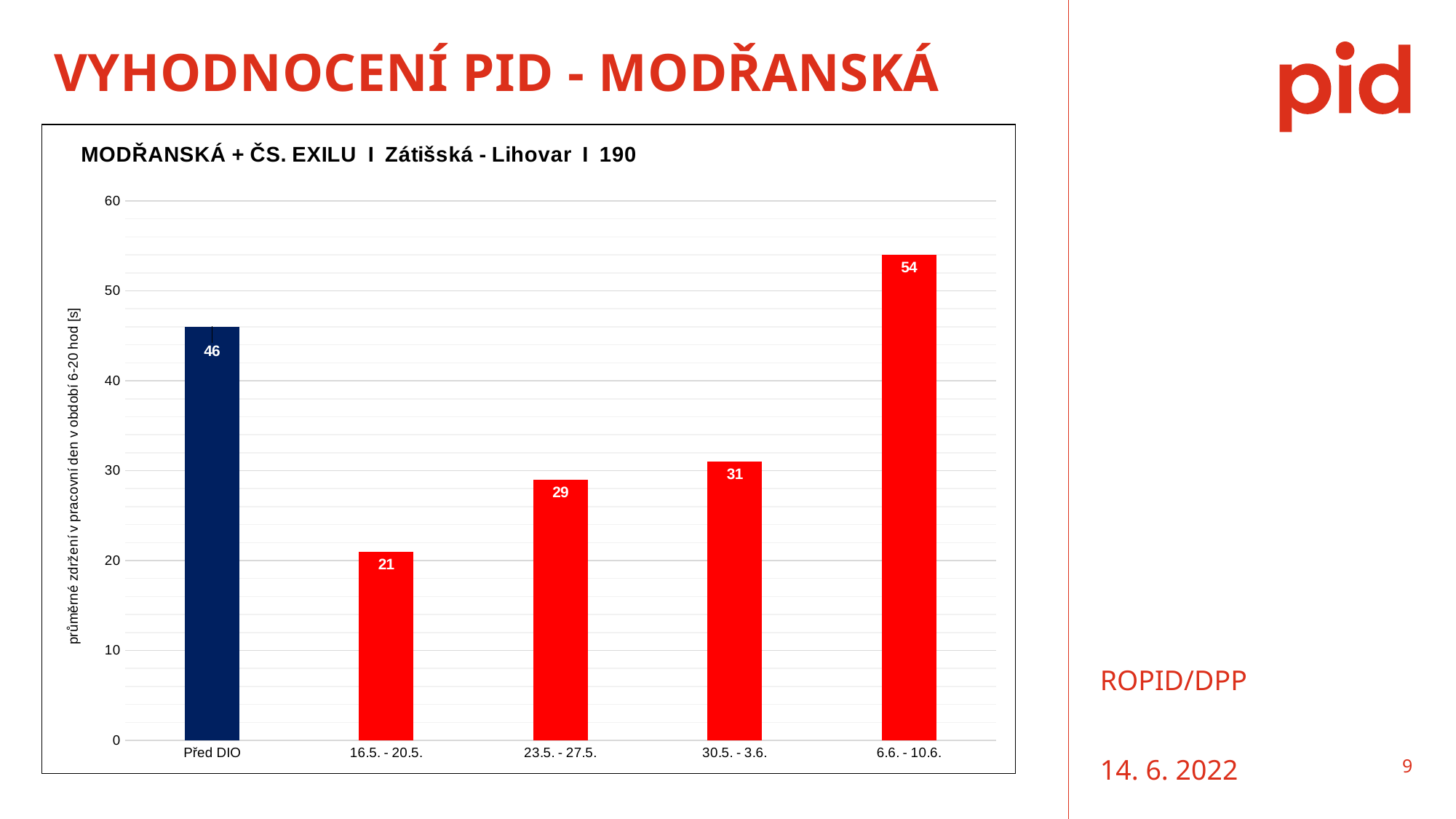
Is the value for 23.5. - 27.5. greater or less than 30? less Which category has the highest value? 6.6. - 10.6. Which category has the lowest value? 16.5. - 20.5. What is the value for 16.5. - 20.5.? 21 What is the chart's title? MODŘANSKÁ + ČS. EXILU I Zátišská - Lihovar I 190 What kind of chart is shown? bar chart What is the difference between the values for 30.5. - 3.6. and 23.5. - 27.5.? 2 Which is larger, the value for Před DIO or the value for 30.5. - 3.6.? Před DIO What is the value for Před DIO? 46 What is the value for 6.6. - 10.6.? 54 What is the difference between the values for 6.6. - 10.6. and Před DIO? 8 How many categories are shown on the x axis? 5